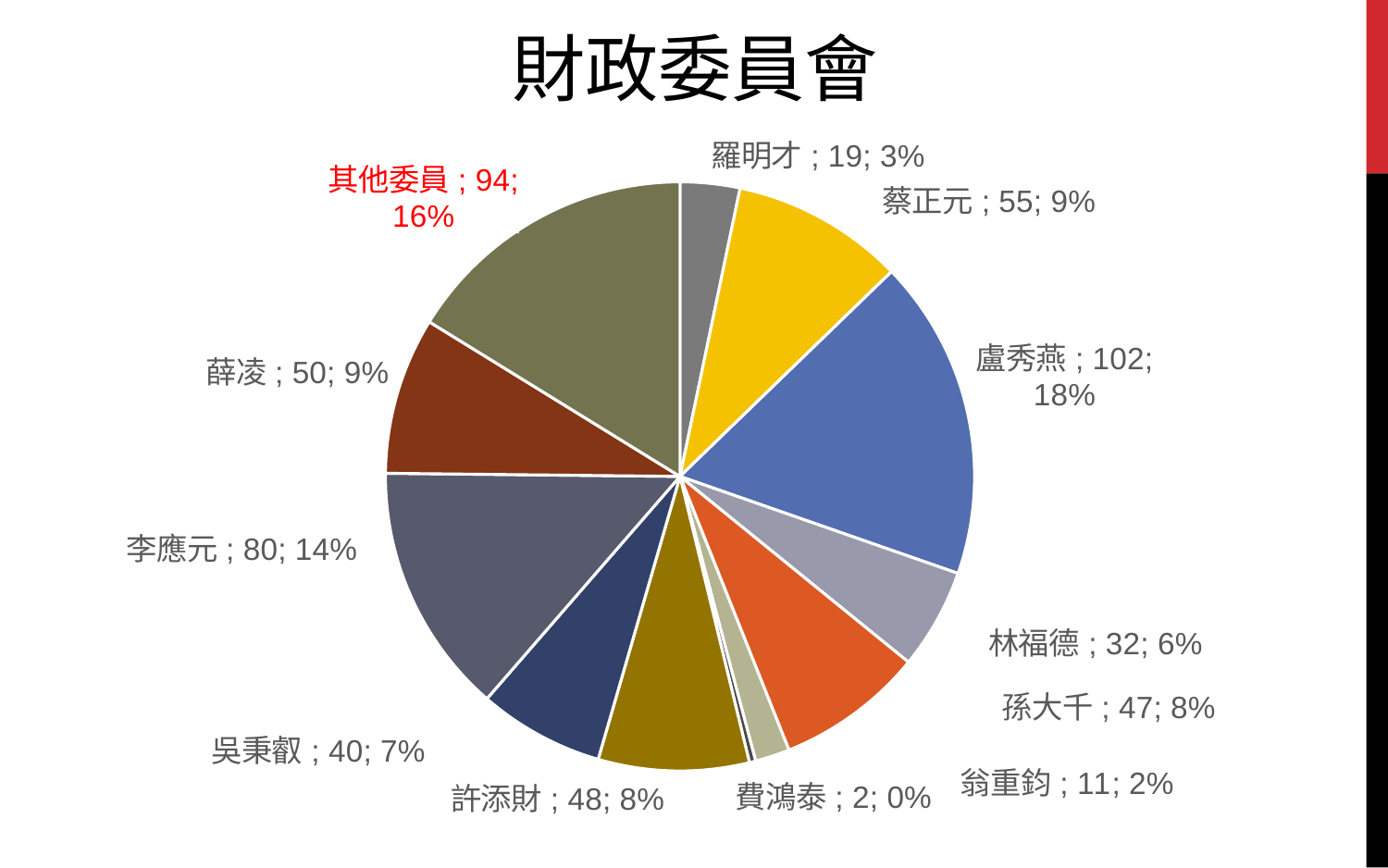
Which is larger, the value for 蔡正元 or the value for 薛凌? 蔡正元 What is the difference between the values for 盧秀燕 and 李應元? 22 What is the value for 其他委員? 94 Which label is shown in red text? 其他委員 What share of the pie does 翁重鈞 represent? 2% Which category has the smallest slice? 費鴻泰 What type of chart is shown on the slide? pie chart What share of the pie does 李應元 represent? 14% What is the chart's title? 財政委員會 How many slices does the pie chart have? 12 What is the value for 盧秀燕? 102 Which category has the largest slice? 盧秀燕